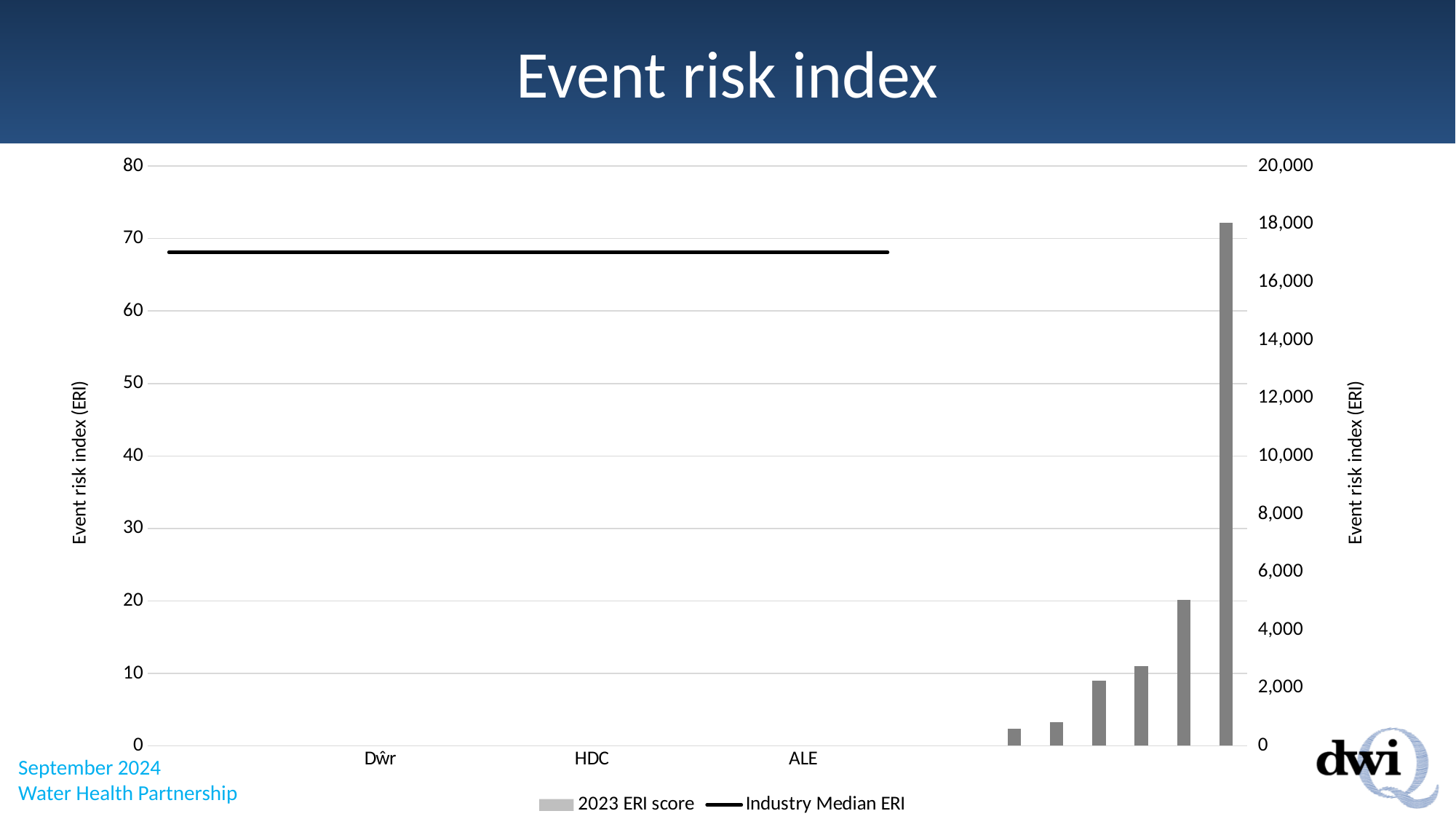
How many series does the legend list? 2 What are the two entries in the chart legend? 2023 ERI score and Industry Median ERI Do the bar values rise or fall from left to right along the x axis? rise What is the title of the chart? Event risk index Is the Industry Median ERI line greater or less than 70 on the left axis? less Is the tallest bar greater or less than 16,000 on the right axis? greater How many bars are plotted on the chart? 6 What kind of chart is shown on the slide? bar and line chart Is the Industry Median ERI line greater or less than 60 on the left axis? greater What is the maximum value shown on the right-hand axis? 20,000 How many category labels are readable on the x axis? 3